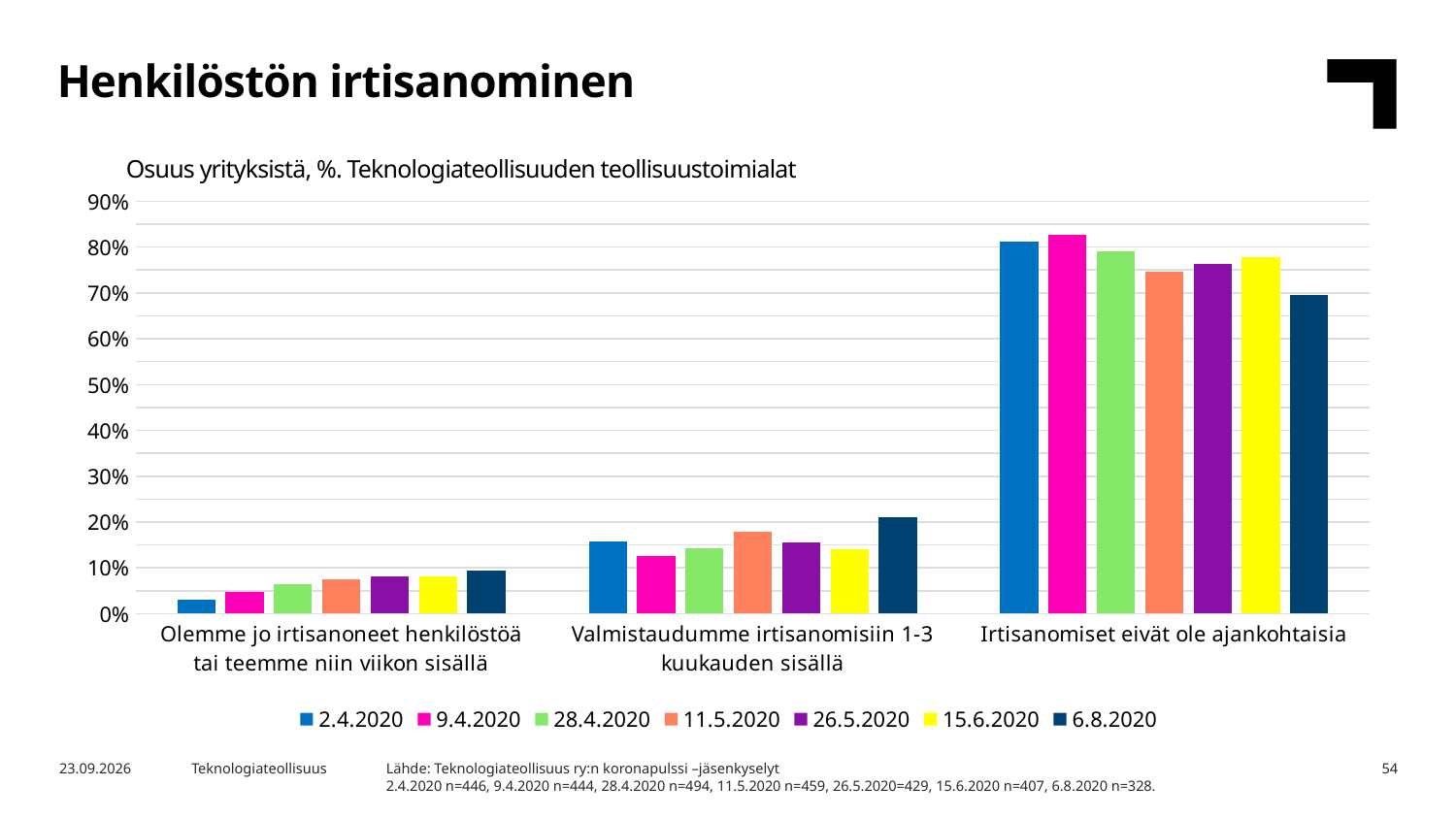
In the category "Olemme jo irtisanoneet henkilöstöä tai teemme niin viikon sisällä", which is larger: the value for 2.4.2020 or for 6.8.2020? 6.8.2020 How many categories are shown on the x axis? 3 Is the value for 6.8.2020 in the category "Irtisanomiset eivät ole ajankohtaisia" greater or less than 80%? less Is the value for 2.4.2020 in the category "Olemme jo irtisanoneet henkilöstöä tai teemme niin viikon sisällä" greater or less than 10%? less What is the subtitle printed above the chart? Osuus yrityksistä, %. Teknologiateollisuuden teollisuustoimialat How many series does the legend list? 7 Which survey date has the lowest value in the category "Irtisanomiset eivät ole ajankohtaisia"? 6.8.2020 Which survey date has the highest value in the category "Valmistaudumme irtisanomisiin 1-3 kuukauden sisällä"? 6.8.2020 What kind of chart is shown on the slide? bar chart In the category "Olemme jo irtisanoneet henkilöstöä tai teemme niin viikon sisällä", do the values rise or fall from 2.4.2020 to 6.8.2020? rise Is the value for 6.8.2020 in the category "Valmistaudumme irtisanomisiin 1-3 kuukauden sisällä" greater or less than 10%? greater